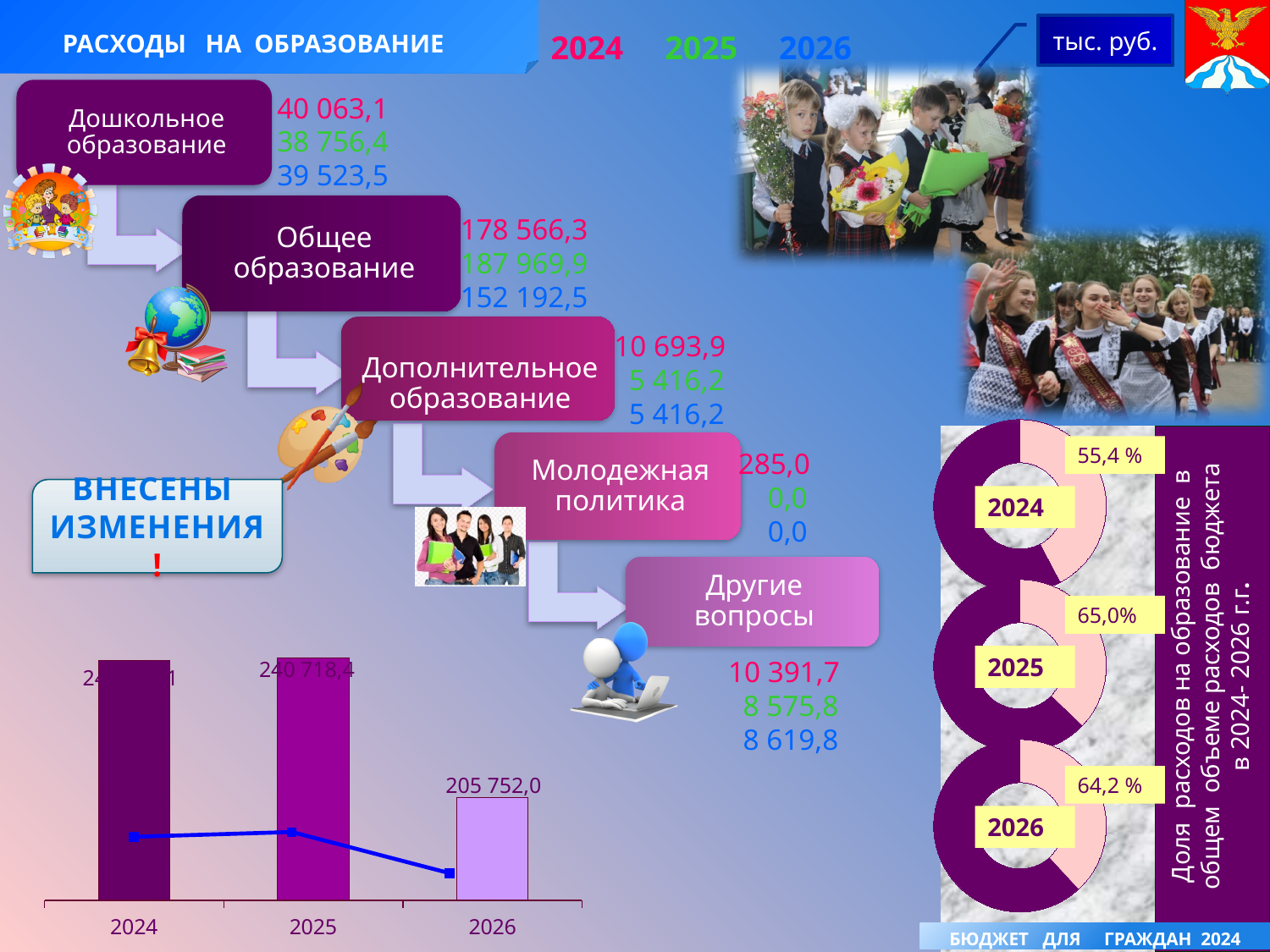
In the bar chart at the bottom left, what is the value for 2026? 205 752,0 In the bar chart at the bottom left, what is the difference between the values for 2025 and 2026? 34 966,4 In the bar chart at the bottom left, what is the value for 2025? 240 718,4 In the donut charts on the right, what share of budget expenditure goes to education in 2025? 65,0% In the donut charts on the right, what share of budget expenditure goes to education in 2024? 55,4 % In the donut charts on the right, which year has the lowest share of education expenditure? 2024 What kind of chart is shown at the bottom left of the slide? Bar chart In the bar chart at the bottom left, which year has the lowest bar? 2026 In the donut charts on the right, what share of budget expenditure goes to education in 2026? 64,2 % How many years are shown on the x axis of the bar chart at the bottom left? 3 In the bar chart at the bottom left, do the values rise or fall from 2025 to 2026? Fall In the bar chart at the bottom left, which is larger, the value for 2025 or the value for 2026? 2025